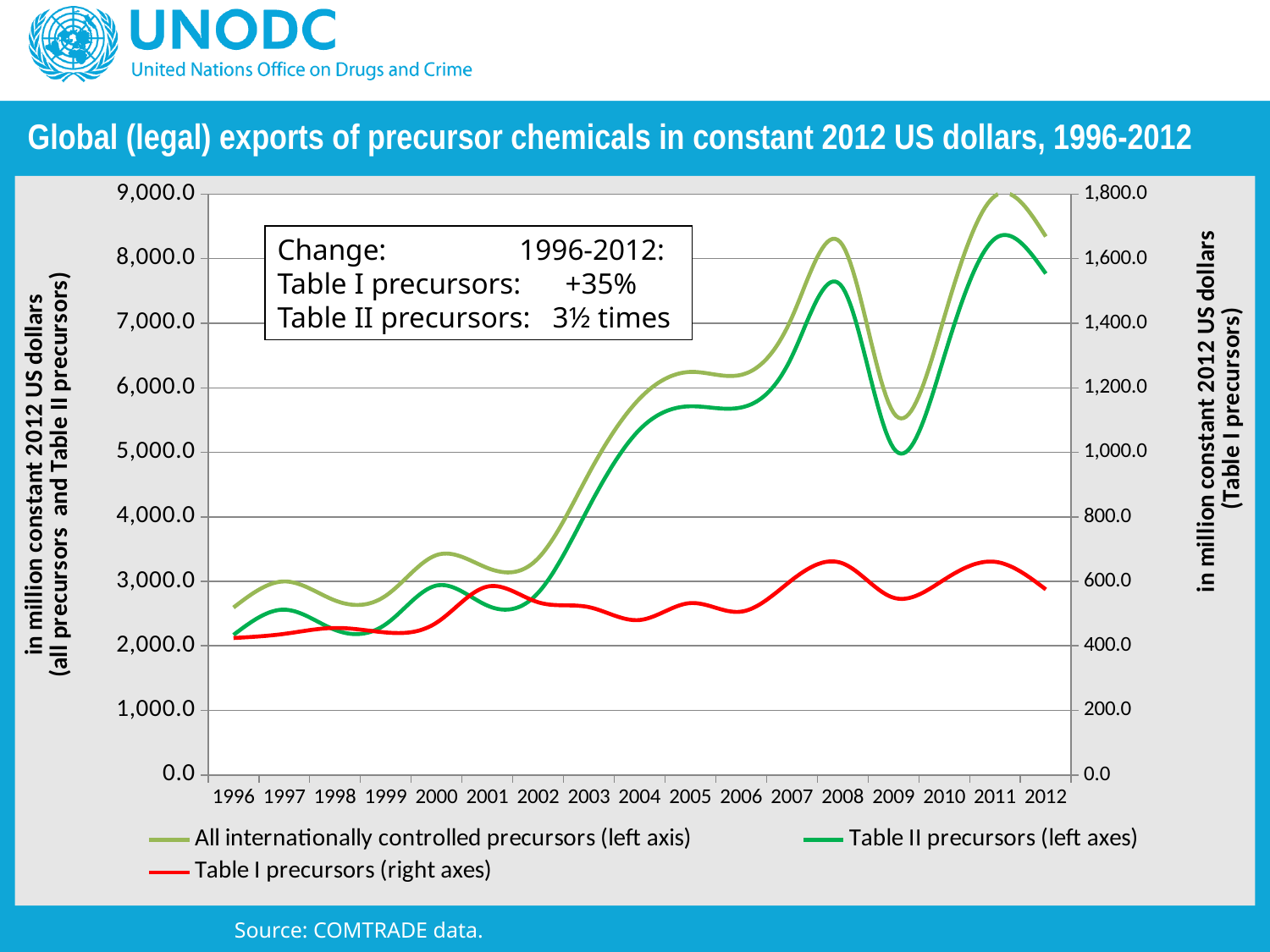
According to the text box on the chart, by how much did Table I precursors change between 1996 and 2012? +35% Which year has the larger value for 'All internationally controlled precursors', 2008 or 2009? 2008 Is the value for 'Table I precursors' in 2008 greater or less than 600.0 on the right axis? greater What kind of chart is shown on the slide? Line chart How many years are shown along the x axis? 17 Overall, do the values for 'Table II precursors' rise or fall from 1996 to 2012? Rise Is the value for 'All internationally controlled precursors' in 2009 greater or less than 6,000.0 on the left axis? less How many series does the legend list? 3 Is the value for 'Table I precursors' in 1996 greater or less than 600.0 on the right axis? less In which year does the 'All internationally controlled precursors' series reach its highest value? 2011